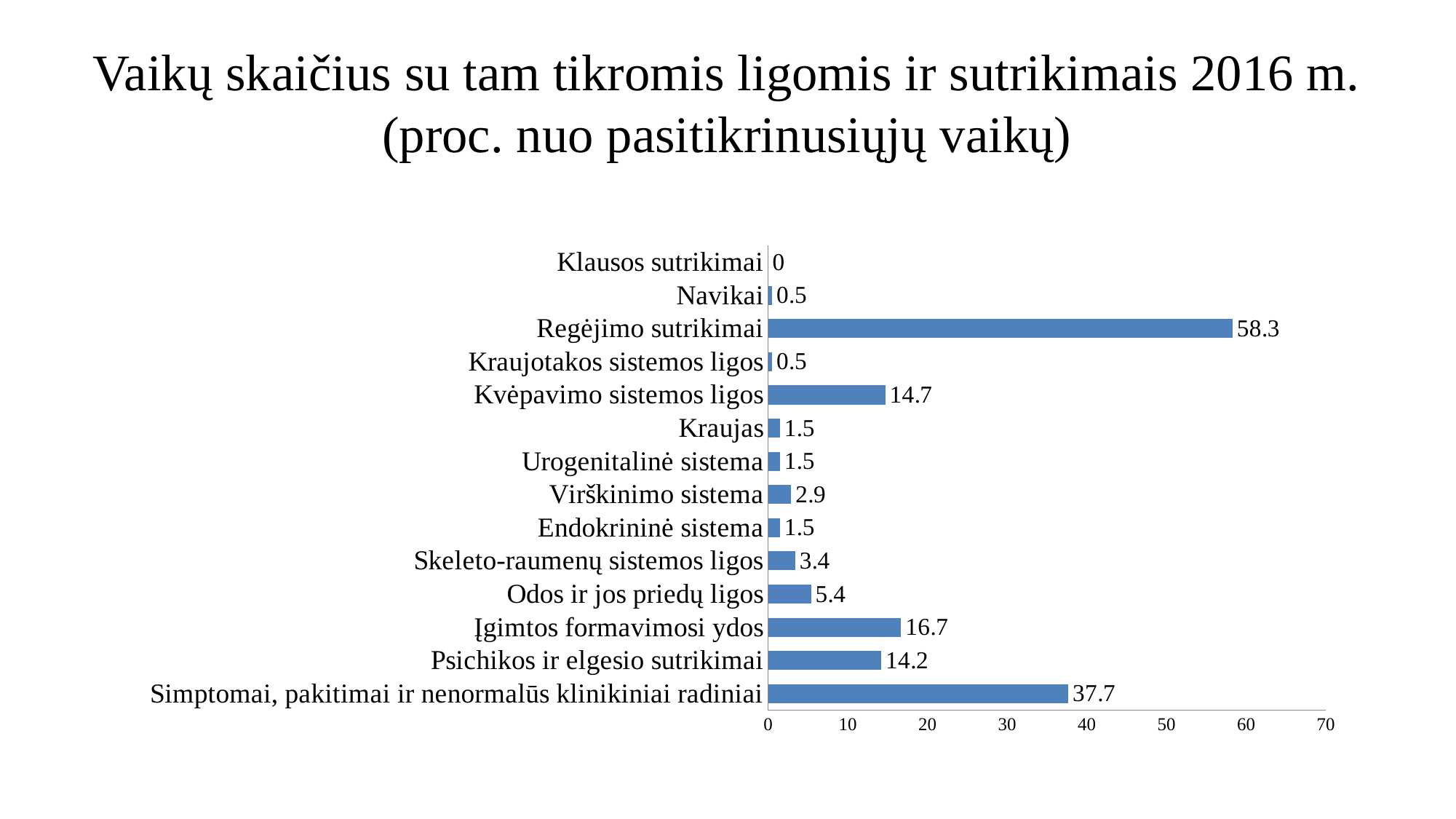
What is the difference between the values for Regėjimo sutrikimai and Simptomai, pakitimai ir nenormalūs klinikiniai radiniai? 20.6 What is the value for Regėjimo sutrikimai? 58.3 Which is larger, the value for Kvėpavimo sistemos ligos or the value for Psichikos ir elgesio sutrikimai? Kvėpavimo sistemos ligos How many categories are shown in the chart? 14 What is the difference between the values for Įgimtos formavimosi ydos and Psichikos ir elgesio sutrikimai? 2.5 What is the maximum value shown on the horizontal axis? 70 What kind of chart is shown on the slide? Bar chart What is the value for Simptomai, pakitimai ir nenormalūs klinikiniai radiniai? 37.7 Which category has the highest value? Regėjimo sutrikimai What is the value for Odos ir jos priedų ligos? 5.4 Which category has the lowest value? Klausos sutrikimai What is the value for Kvėpavimo sistemos ligos? 14.7